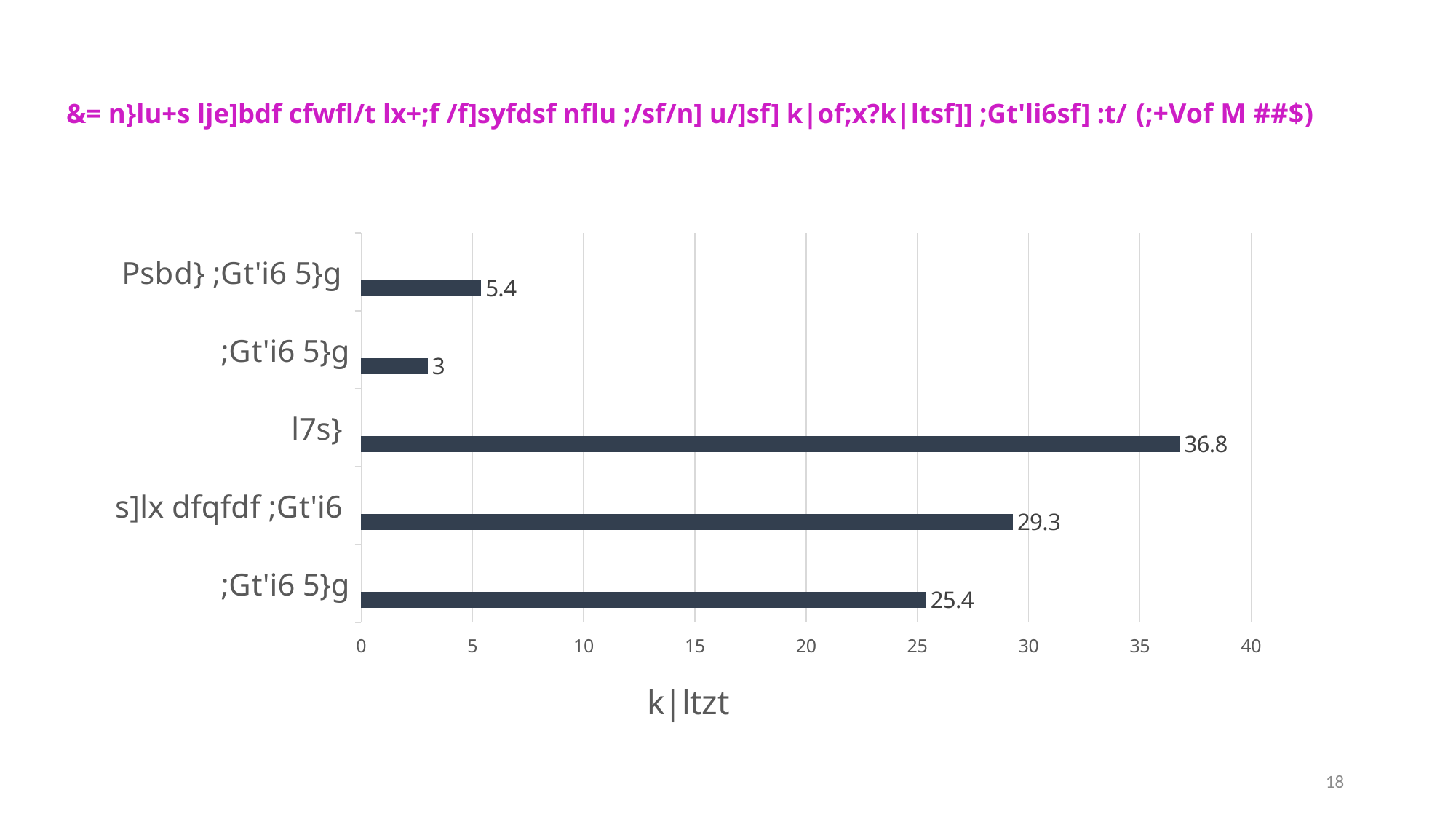
What kind of chart is shown on the slide? bar chart What is the value for the category "l7s}"? 36.8 What is the value of the bottom bar in the chart? 25.4 What is the value of the second bar from the top? 3 Which is larger, the value for "l7s}" or the value for "s]lx dfqfdf ;Gt'i6"? l7s} What is the value for the category "Psbd} ;Gt'i6 5}g"? 5.4 Which category has the highest value? l7s} What is the title of the horizontal axis? k|ltzt What is the smallest value shown in the chart? 3 What is the difference between the values for "l7s}" and "s]lx dfqfdf ;Gt'i6"? 7.5 How many categories are shown in the chart? 5 What is the value for the category "s]lx dfqfdf ;Gt'i6"? 29.3